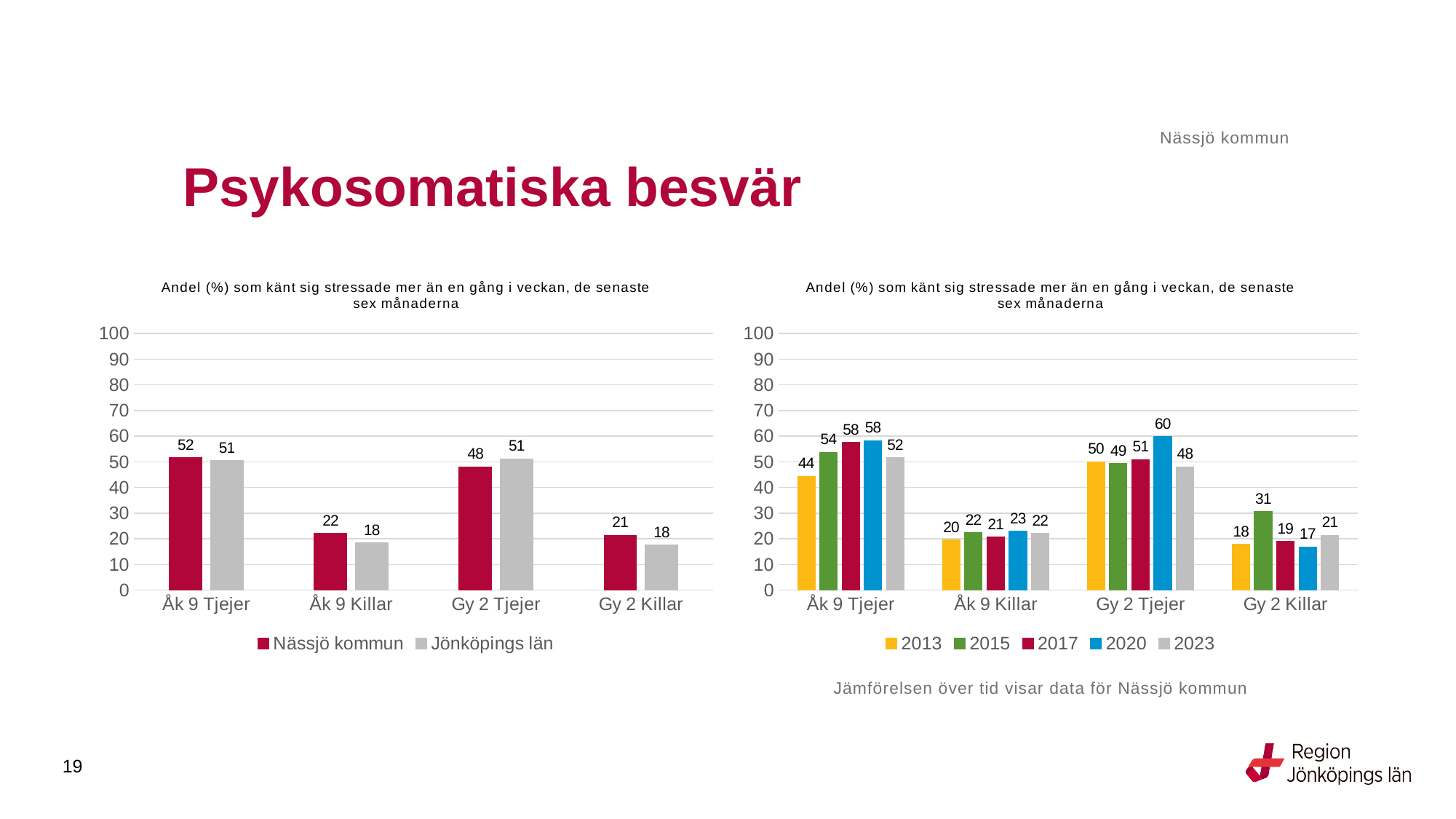
In the left chart, which category has the highest value for Nässjö kommun? Åk 9 Tjejer In the right chart, which is larger for Åk 9 Tjejer: the value for 2015 or the value for 2023? 2015 What kind of chart is the right chart? Bar chart In the left chart, how many series does the legend list? 2 In the right chart, what is the difference between the 2015 and 2013 values for Gy 2 Killar? 13 In the left chart, what is the difference between Nässjö kommun and Jönköpings län for Åk 9 Killar? 4 In the right chart, what is the value for 2013 for Åk 9 Tjejer? 44 In the right chart, what is the value for 2020 for Gy 2 Tjejer? 60 In the right chart, how many series does the legend list? 5 In the right chart, which year has the lowest value for Gy 2 Killar? 2020 In the left chart, what is the value for Nässjö kommun for Åk 9 Tjejer? 52 In the left chart, what is the value for Jönköpings län for Gy 2 Killar? 18